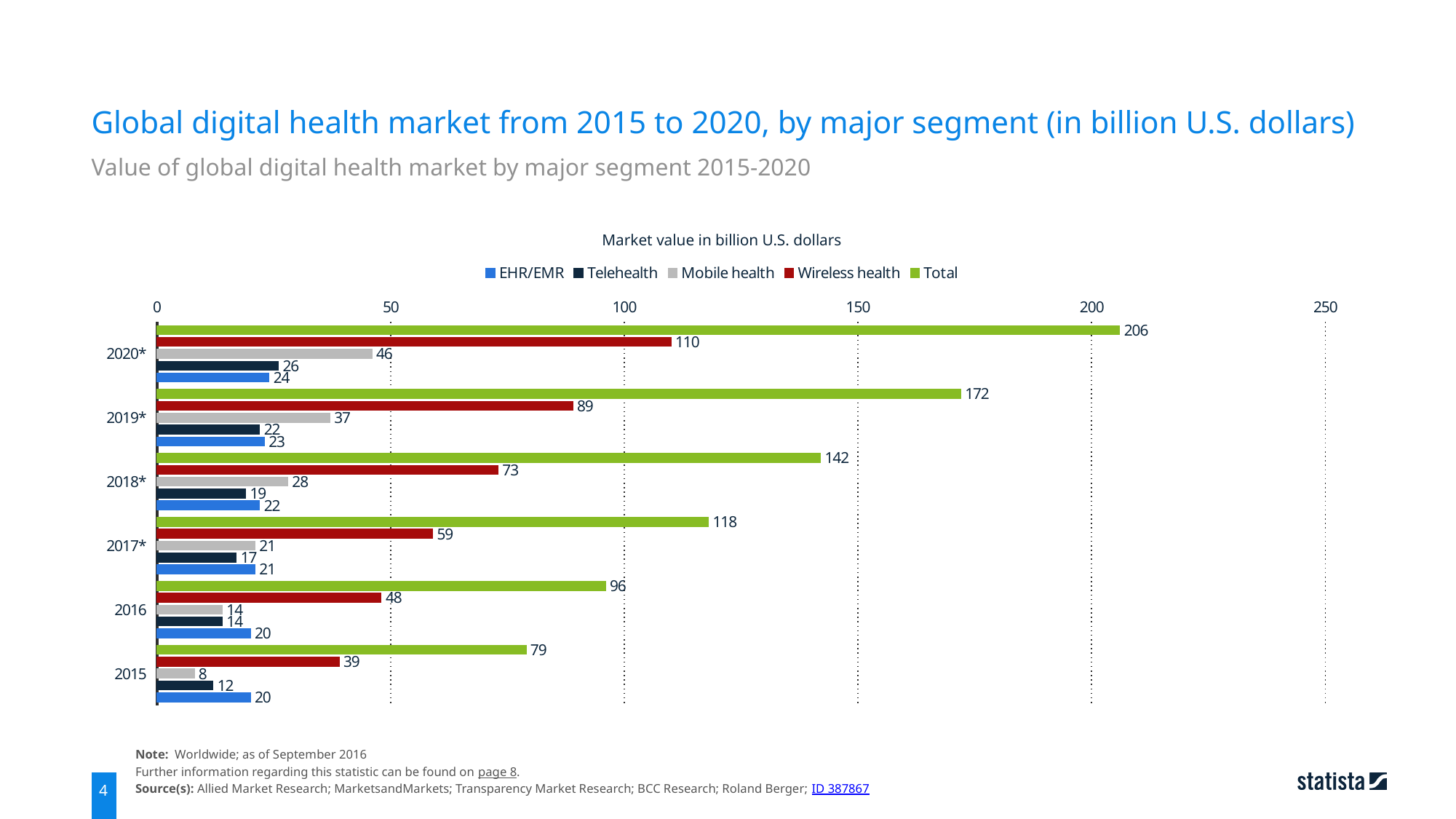
What is the Mobile health value for 2015? 8 What is the difference between the Total values for 2020* and 2019*? 34 What kind of chart is shown on the slide? bar chart What is the Telehealth value for 2017*? 17 Which year has the highest Total market value? 2020* Is the Total value for 2018* greater or less than 150? less How many series does the legend list? 5 Which is larger in 2016: the EHR/EMR value or the Wireless health value? Wireless health Which year has the lowest Mobile health value? 2015 What is the Wireless health value for 2018*? 73 What is the Total market value for 2020*? 206 How many years are shown on the chart? 6